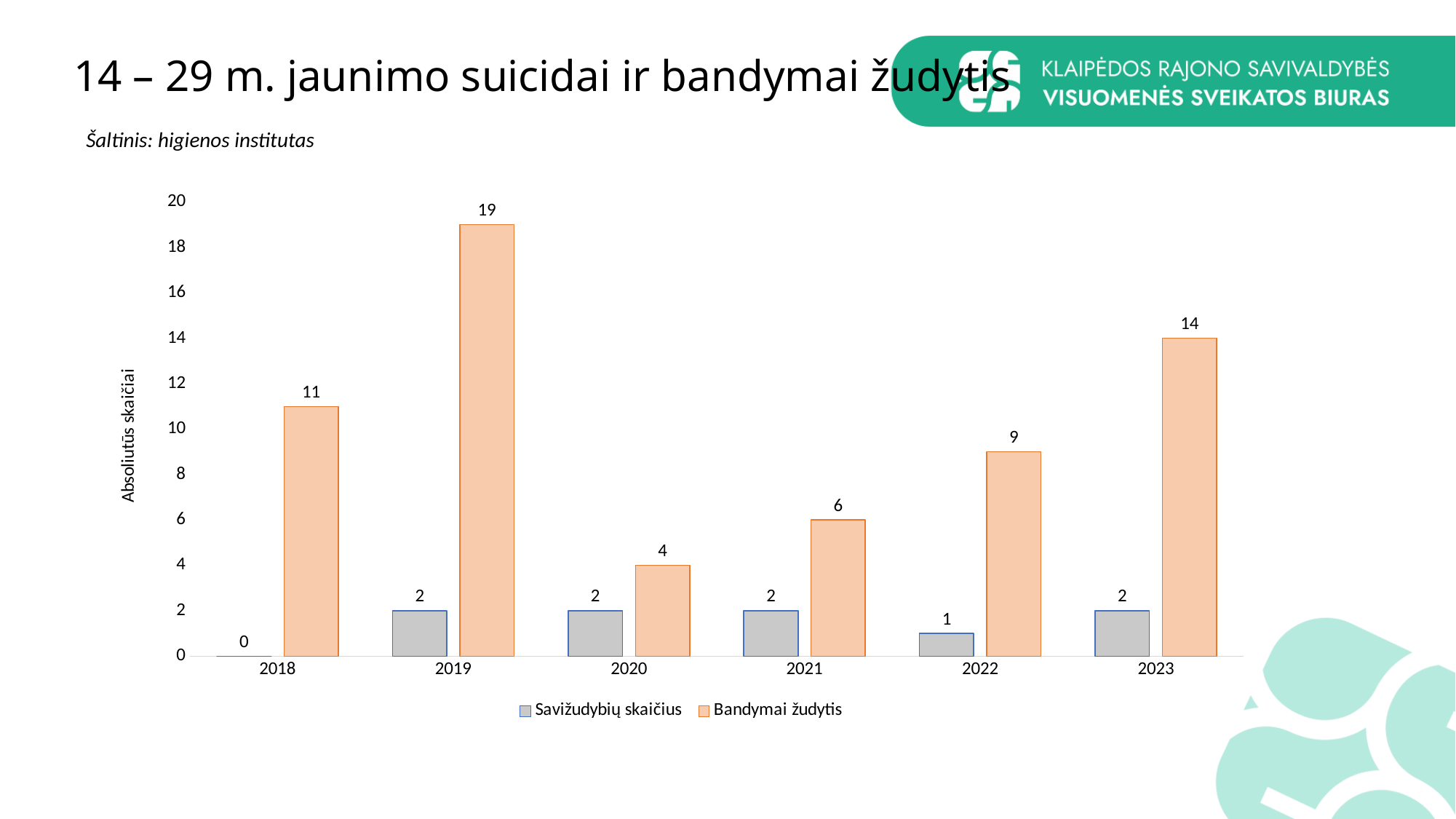
How many years are shown on the x axis? 6 Does Bandymai žudytis rise or fall from 2020 to 2023? rise How many series does the legend list? 2 What is the value of Bandymai žudytis for 2023? 14 Which year has the highest value for Bandymai žudytis? 2019 Which is larger: Bandymai žudytis in 2018 or in 2022? 2018 What is the difference between Bandymai žudytis in 2019 and in 2020? 15 What is the value of Bandymai žudytis for 2019? 19 Which year has the lowest value for Bandymai žudytis? 2020 What kind of chart is shown on the slide? bar chart What is the label of the y axis? Absoliutūs skaičiai What is the value of Savižudybių skaičius for 2022? 1